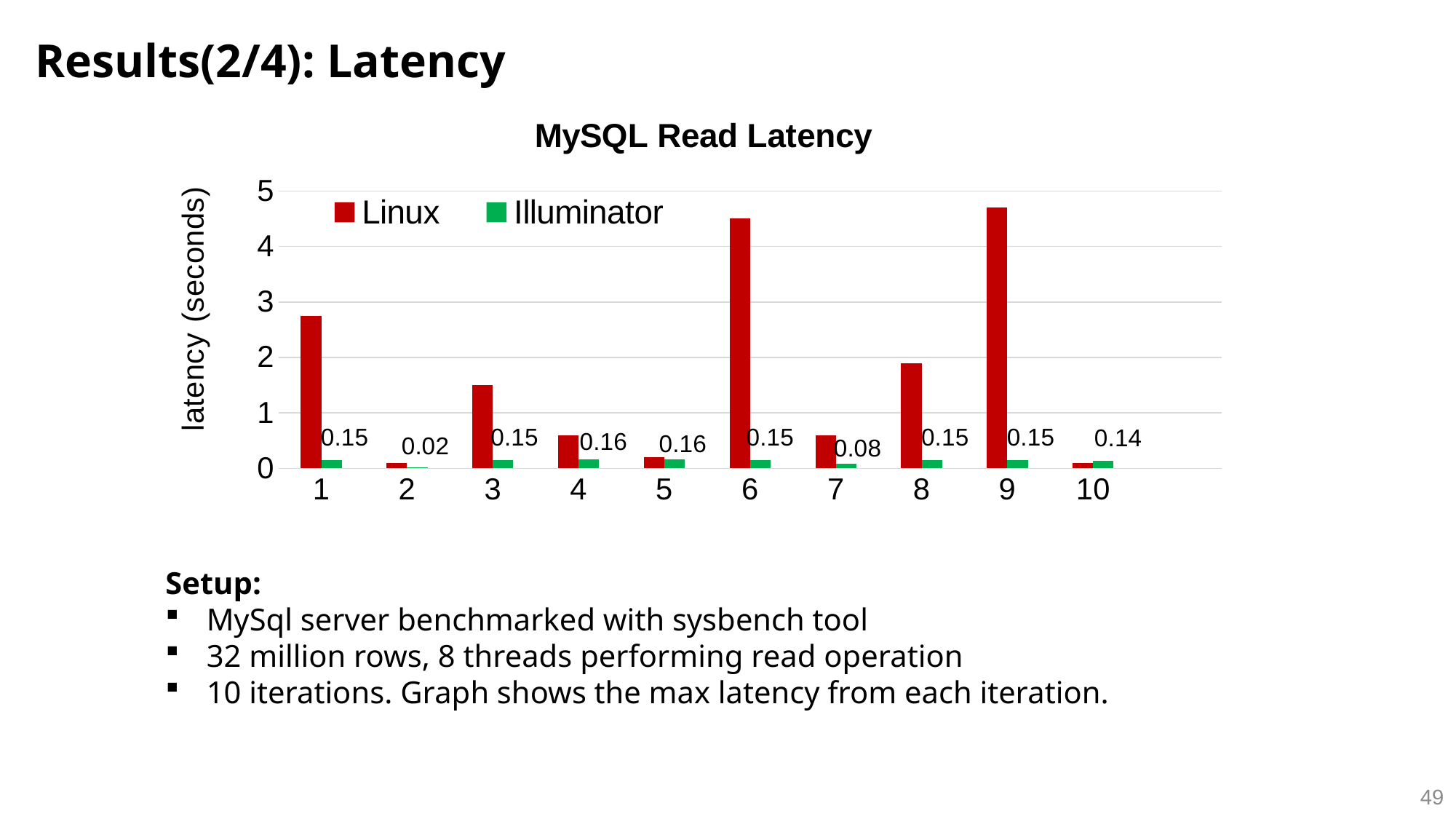
What is the Illuminator latency at iteration 7? 0.08 At iteration 6, which series has the higher latency, Linux or Illuminator? Linux At which iteration is the Illuminator latency lowest? 2 What type of chart is shown on the slide? bar chart What is the difference between the Illuminator latency at iteration 4 and at iteration 2? 0.14 What is the title of the chart? MySQL Read Latency Is the Linux latency at iteration 1 greater or less than 2? greater What is the Illuminator latency at iteration 2? 0.02 How many iterations are plotted along the x axis? 10 Is the Linux latency at iteration 6 greater or less than 4? greater How many series does the legend list? 2 What is the Illuminator latency at iteration 10? 0.14